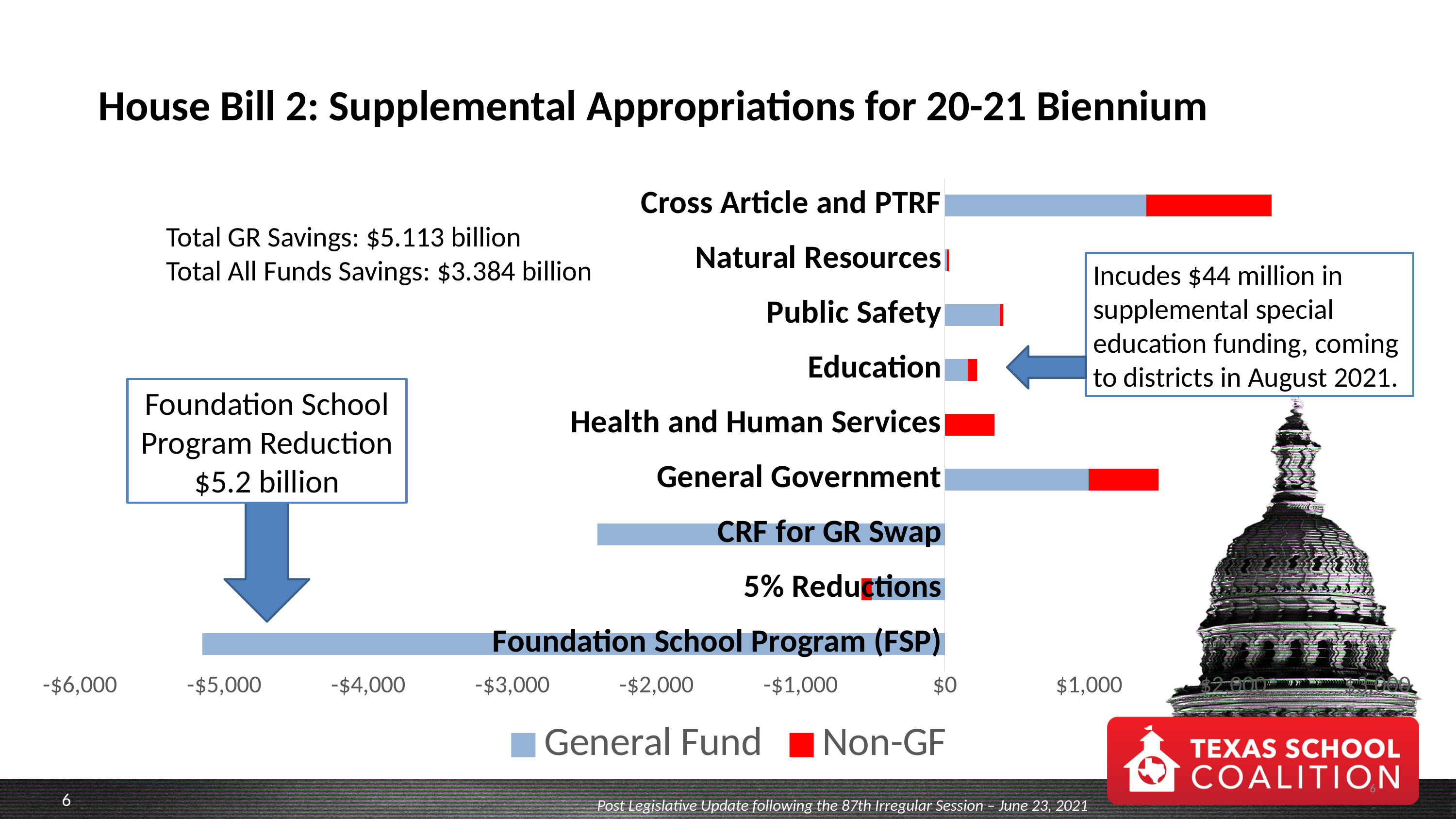
Is the total value for General Government greater or less than $1,000? greater Which category has the most negative (lowest) value on the chart? Foundation School Program (FSP) Is the value for CRF for GR Swap greater or less than -$2,000? less What kind of chart is shown on the slide? bar chart Is the value for Health and Human Services greater or less than $1,000? less Which category has the largest positive total on the chart? Cross Article and PTRF What are the two series named in the chart legend? General Fund and Non-GF Which has the larger total value, Cross Article and PTRF or General Government? Cross Article and PTRF How many categories are plotted on the chart? 9 How many series does the chart legend list? 2 Which colour represents the Non-GF series in the chart? red